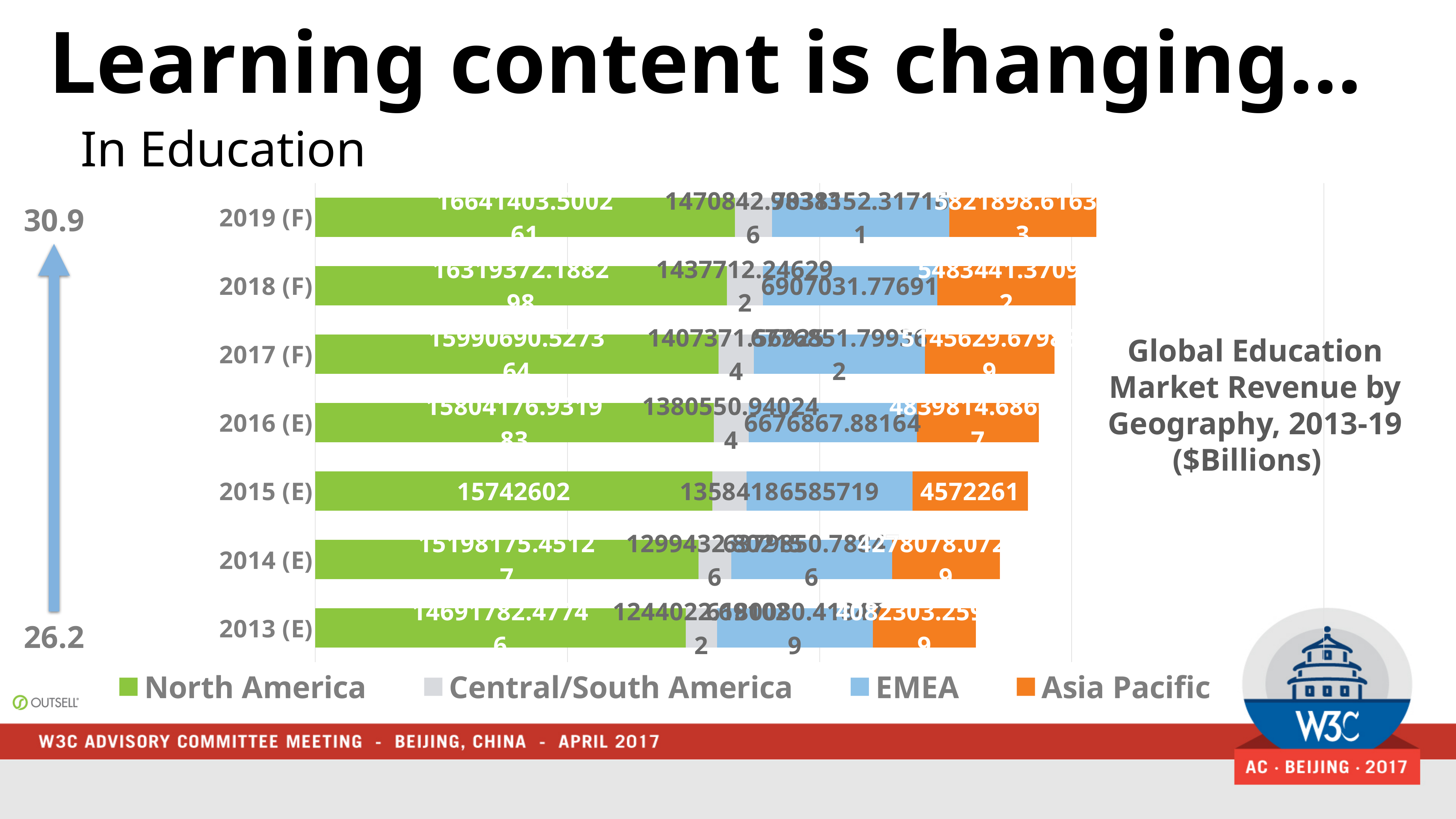
What kind of chart is shown on the slide? Stacked bar chart What is the EMEA value for 2018 (F)? 6907031.77691 What is the North America value for 2015 (E)? 15742602 Do the total bar lengths rise or fall from 2013 (E) to 2019 (F)? Rise How many year categories are plotted on the chart? 7 Which series has the largest segment in every bar? North America What is the EMEA value for 2016 (E)? 6676867.88164 What is the difference between the North America and Asia Pacific values for 2015 (E)? 11170341 Which year has the longest total bar? 2019 (F) How many series does the chart legend list? 4 What is the title of the chart? Global Education Market Revenue by Geography, 2013-19 ($Billions) What is the Asia Pacific value for 2015 (E)? 4572261